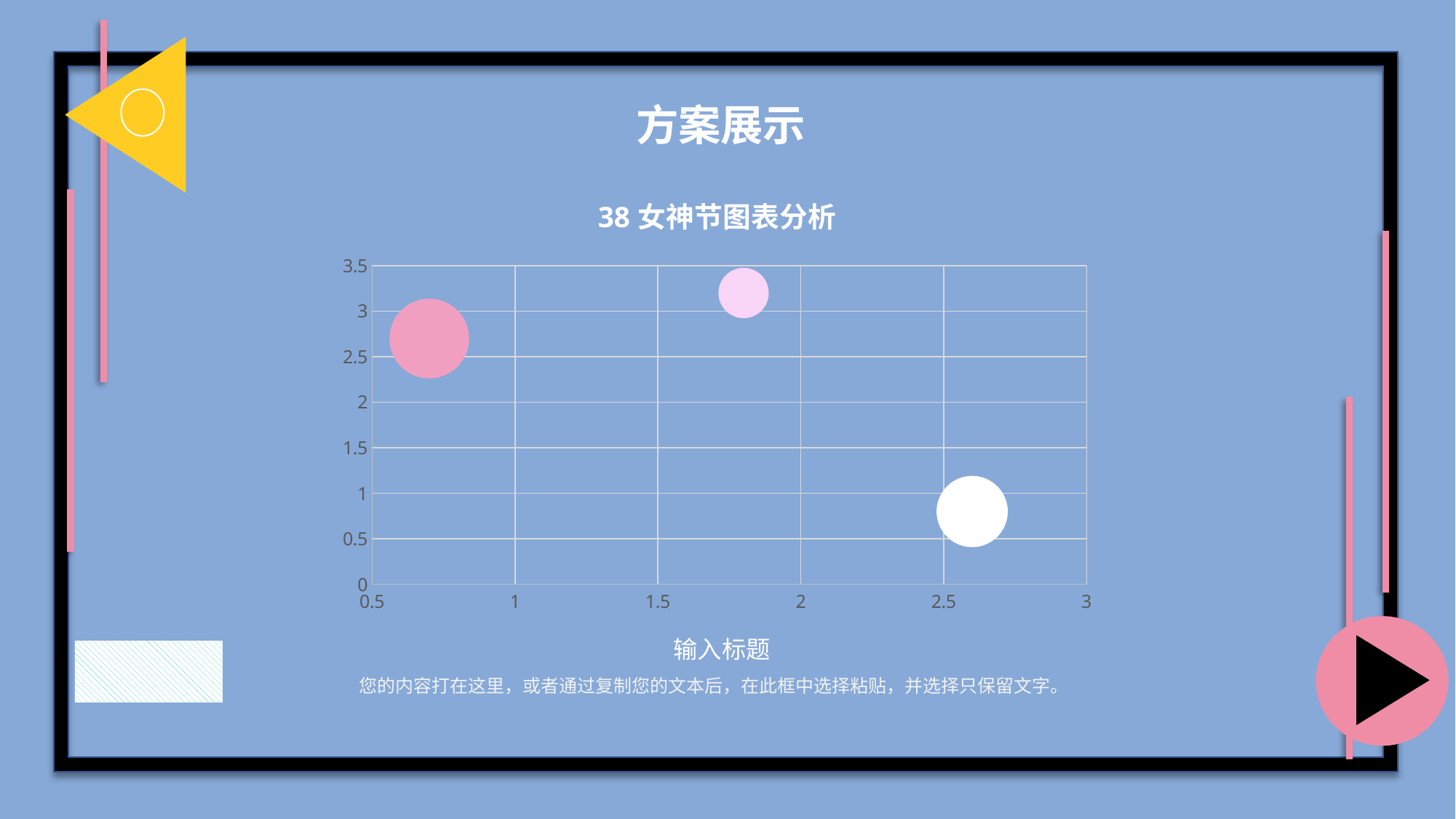
Is the y value of the white bubble greater or less than 1? less Which bubble has the lowest vertical (y-axis) position? the white bubble near x = 2.6 Which bubble has the highest vertical (y-axis) position? the light pink bubble near x = 1.8 Which has the larger y value, the white bubble or the large pink bubble on the left? the large pink bubble on the left What is the highest value shown on the y axis? 3.5 Is the y value of the large pink bubble on the left greater or less than 2.5? greater What is the title of the chart? 38 女神节图表分析 What kind of chart is shown on the slide? bubble chart How many bubbles are plotted on the chart? 3 Which bubble is the largest in size? the pink bubble on the left near x = 0.7 Is the x value of the white bubble greater or less than 2.5? greater